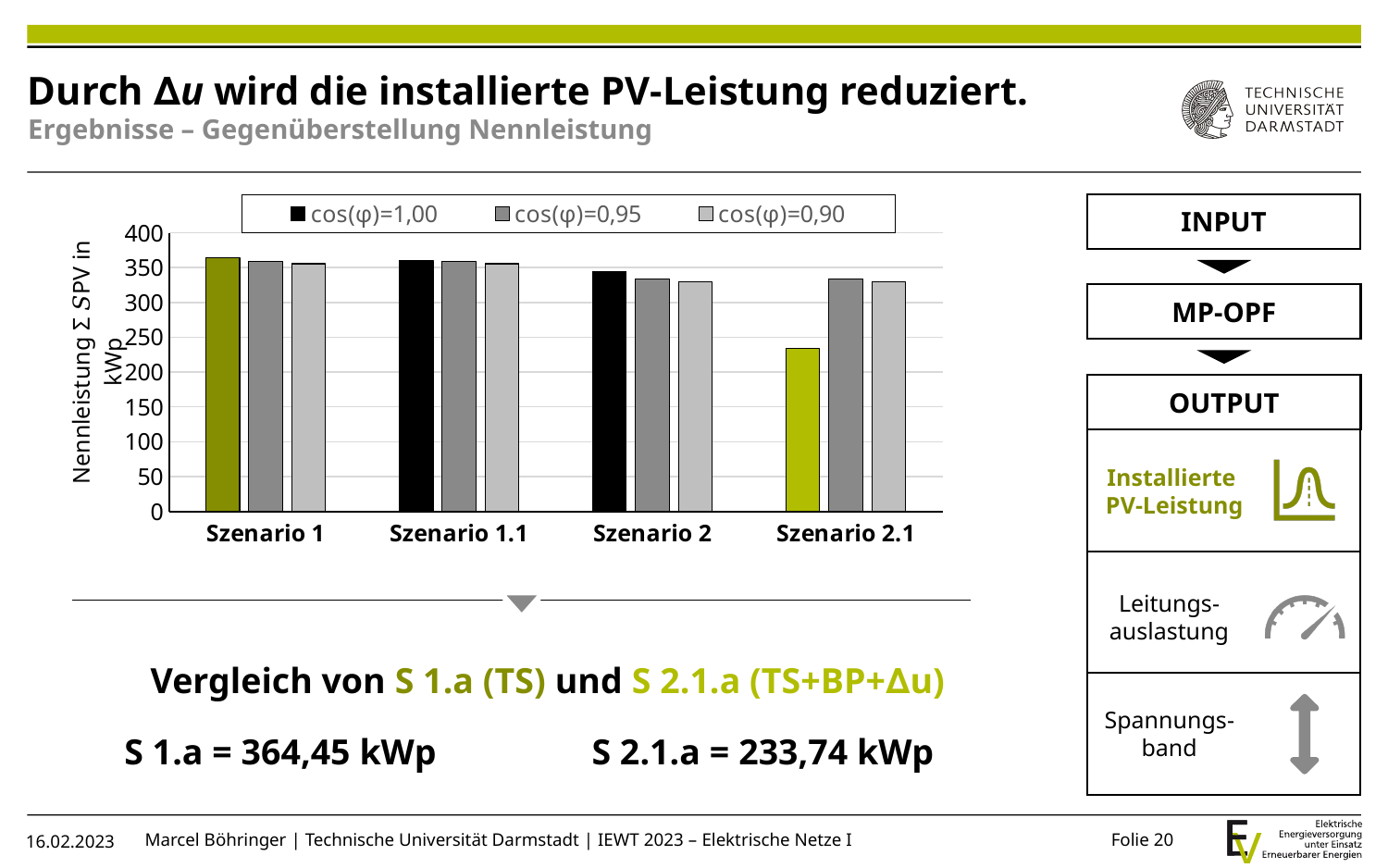
Which series are listed in the chart legend? cos(φ)=1,00, cos(φ)=0,95, cos(φ)=0,90 What kind of chart is shown on the slide? bar chart How many series does the chart legend list? 3 What is the difference between S 1.a (364,45 kWp) and S 2.1.a (233,74 kWp) as given on the slide? 130,71 kWp How many scenarios (categories) are shown on the x axis of the chart? 4 What is the label of the y axis of the chart? Nennleistung Σ SPV in kWp Is the value for Szenario 2.1 with cos(φ)=1,00 greater or less than 250? less Which bar in the chart is the lowest? Szenario 2.1, cos(φ)=1,00 According to the slide, what is the installed PV power (Nennleistung) for S 2.1.a? 233,74 kWp Is the value for Szenario 2 with cos(φ)=0,90 greater or less than 350? less In Szenario 2.1, which is larger: the bar for cos(φ)=1,00 or the bar for cos(φ)=0,95? cos(φ)=0,95 Is the value for Szenario 1 with cos(φ)=0,90 greater or less than 300? greater